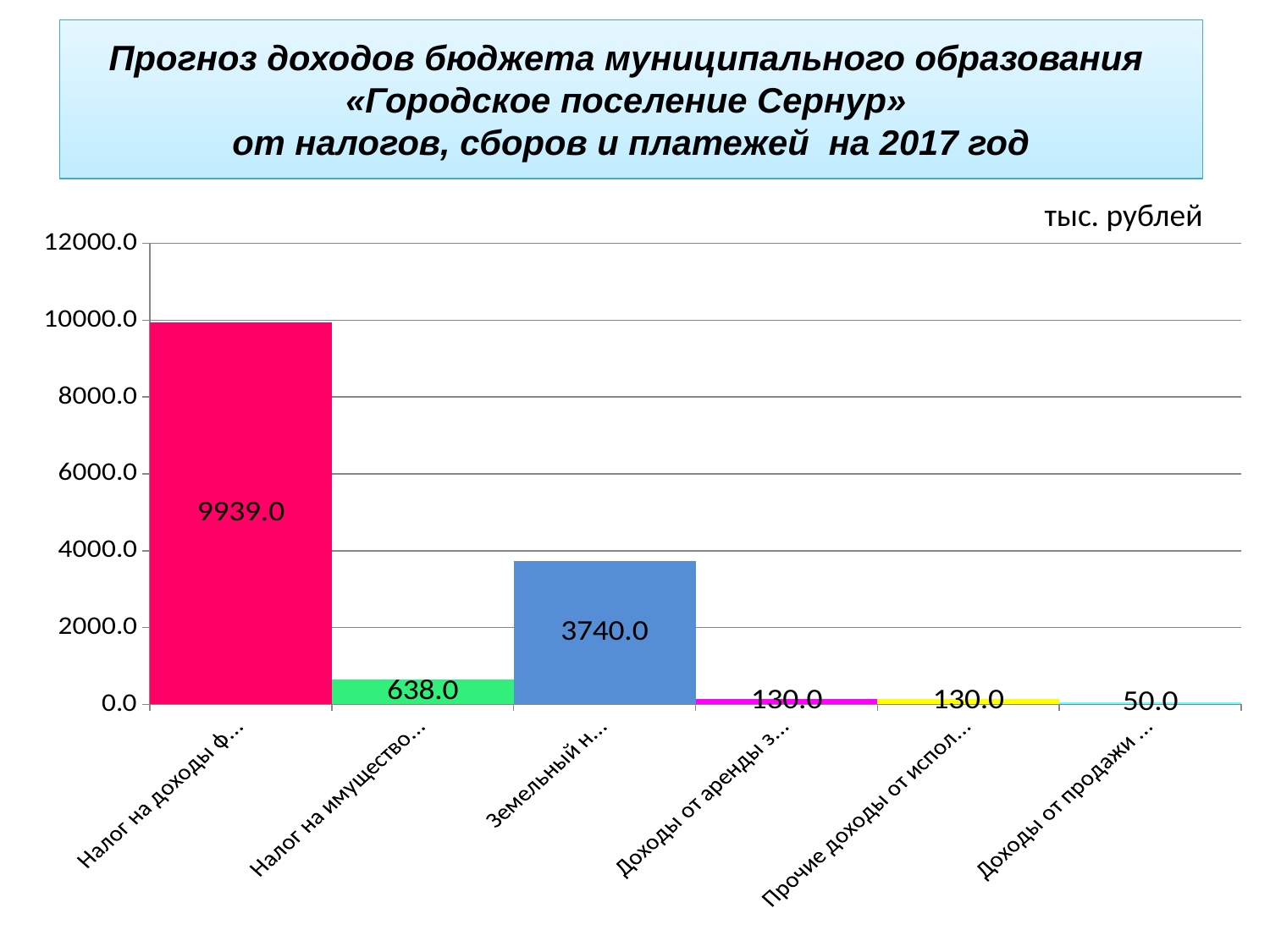
How many categories (bars) are plotted in the chart? 6 What is the value of the bar for the category beginning "Налог на доходы ф..."? 9939.0 Which category has the highest value in the chart? Налог на доходы ф... Which is larger: the value for "Налог на имущество..." or the value for "Земельный н..."? Земельный н... What is the value of the bar for the category beginning "Земельный н..."? 3740.0 Which category has the lowest value in the chart? Доходы от продажи ... What type of chart is shown on the slide? bar chart What unit of measurement is indicated above the chart? тыс. рублей What is the difference between the values for "Налог на доходы ф..." and "Земельный н..."? 6199.0 What is the value of the bar for the category beginning "Доходы от продажи..."? 50.0 What is the value of the bar for the category beginning "Налог на имущество..."? 638.0 Is the value for "Налог на доходы ф..." greater or less than 8000.0? greater